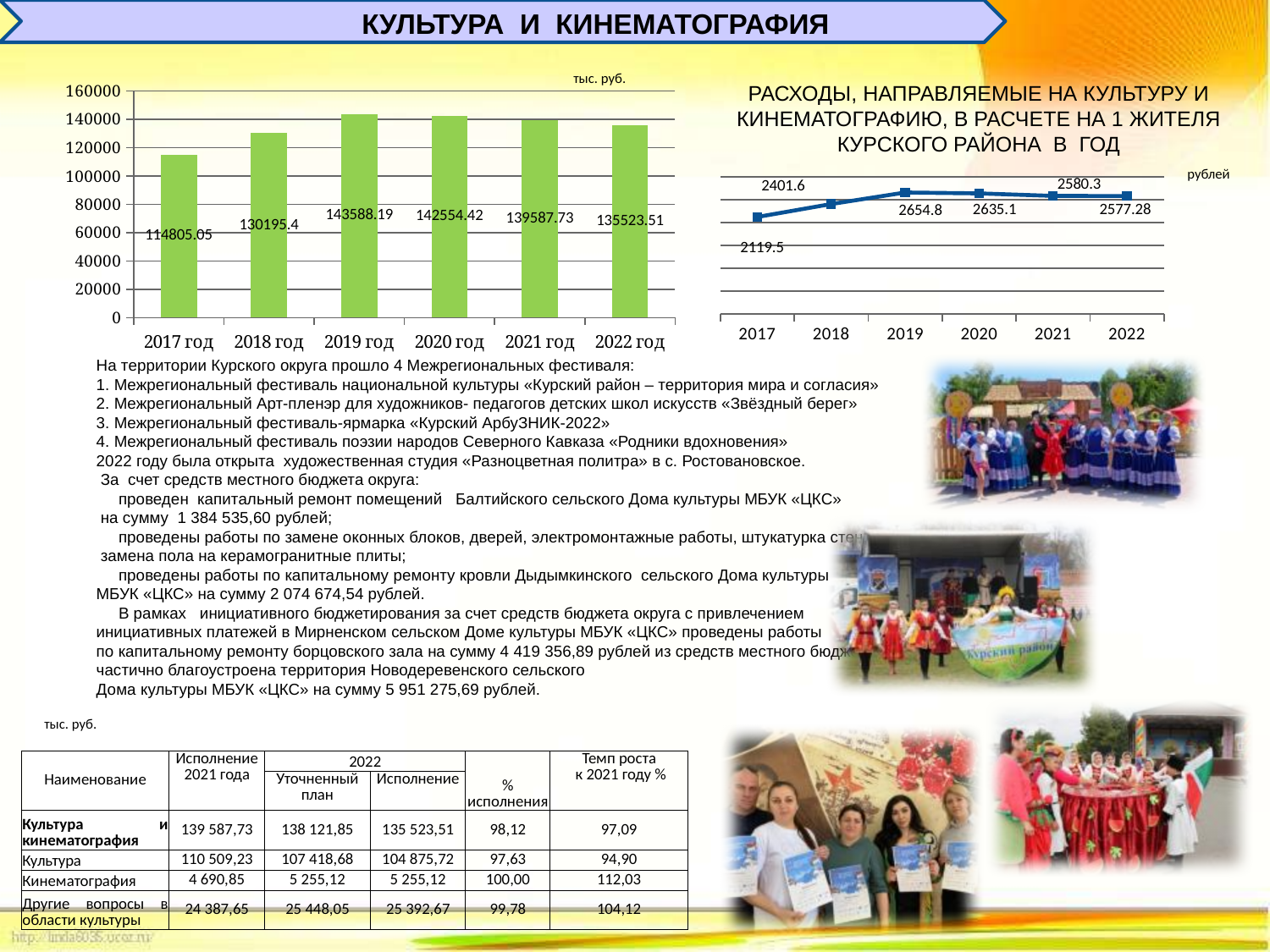
In the chart titled 'РАСХОДЫ, НАПРАВЛЯЕМЫЕ НА КУЛЬТУРУ И КИНЕМАТОГРАФИЮ, В РАСЧЕТЕ НА 1 ЖИТЕЛЯ КУРСКОГО РАЙОНА В ГОД', is the value for 2018 larger or smaller than the value for 2021? smaller In the bar chart on the left of the slide, which year has the lowest value? 2017 год In the bar chart on the left of the slide, which year has the highest value? 2019 год In the chart titled 'РАСХОДЫ, НАПРАВЛЯЕМЫЕ НА КУЛЬТУРУ И КИНЕМАТОГРАФИЮ, В РАСЧЕТЕ НА 1 ЖИТЕЛЯ КУРСКОГО РАЙОНА В ГОД', which year has the lowest value? 2017 In the bar chart on the left of the slide, what is the difference between the values for 2018 год and 2017 год? 15390.35 In the chart titled 'РАСХОДЫ, НАПРАВЛЯЕМЫЕ НА КУЛЬТУРУ И КИНЕМАТОГРАФИЮ, В РАСЧЕТЕ НА 1 ЖИТЕЛЯ КУРСКОГО РАЙОНА В ГОД', what is the value for 2019? 2654.8 In the bar chart on the left of the slide, what is the value for 2017 год? 114805.05 In the bar chart on the left of the slide, how many years are shown? 6 In the chart titled 'РАСХОДЫ, НАПРАВЛЯЕМЫЕ НА КУЛЬТУРУ И КИНЕМАТОГРАФИЮ, В РАСЧЕТЕ НА 1 ЖИТЕЛЯ КУРСКОГО РАЙОНА В ГОД', what is the value for 2022? 2577.28 What type of chart is the chart on the left of the slide? bar chart What type of chart is the chart titled 'РАСХОДЫ, НАПРАВЛЯЕМЫЕ НА КУЛЬТУРУ И КИНЕМАТОГРАФИЮ, В РАСЧЕТЕ НА 1 ЖИТЕЛЯ КУРСКОГО РАЙОНА В ГОД'? line chart In the bar chart on the left of the slide, what is the value for 2019 год? 143588.19